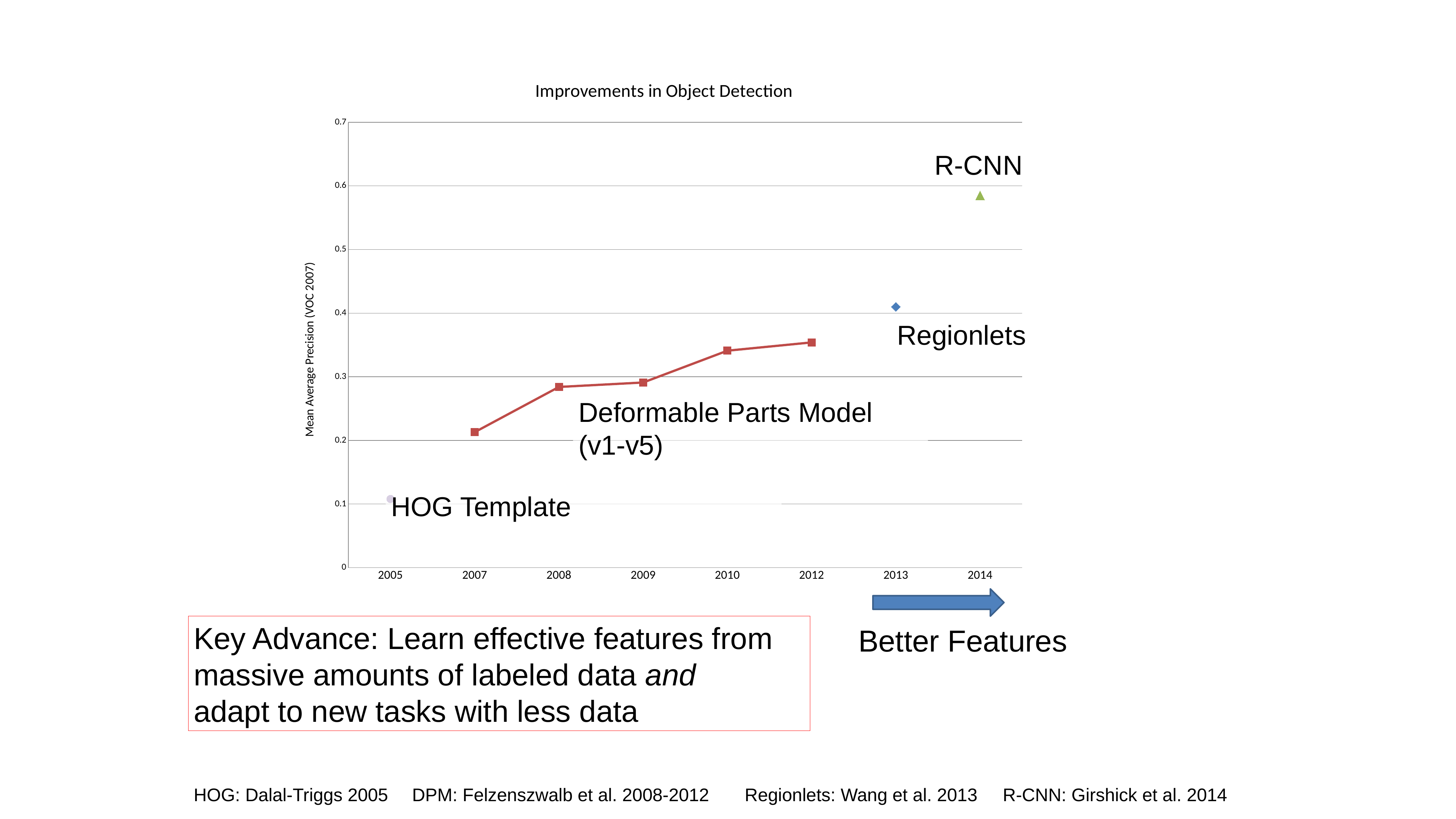
Is the mean average precision for Regionlets in 2013 greater or less than 0.5? less What is the title of the chart? Improvements in Object Detection Is the mean average precision for R-CNN in 2014 greater or less than 0.5? greater Which year has the lowest mean average precision in the chart? 2005 What is the label on the vertical axis of the chart? Mean Average Precision (VOC 2007) What kind of chart is shown on the slide? line chart Is the mean average precision for the Deformable Parts Model in 2007 greater or less than 0.3? less How many years are labeled along the x axis of the chart? 8 Which has a higher mean average precision, Regionlets in 2013 or the Deformable Parts Model in 2012? Regionlets in 2013 Which year has the highest mean average precision in the chart? 2014 Do the mean average precision values generally rise or fall from 2005 to 2014? rise